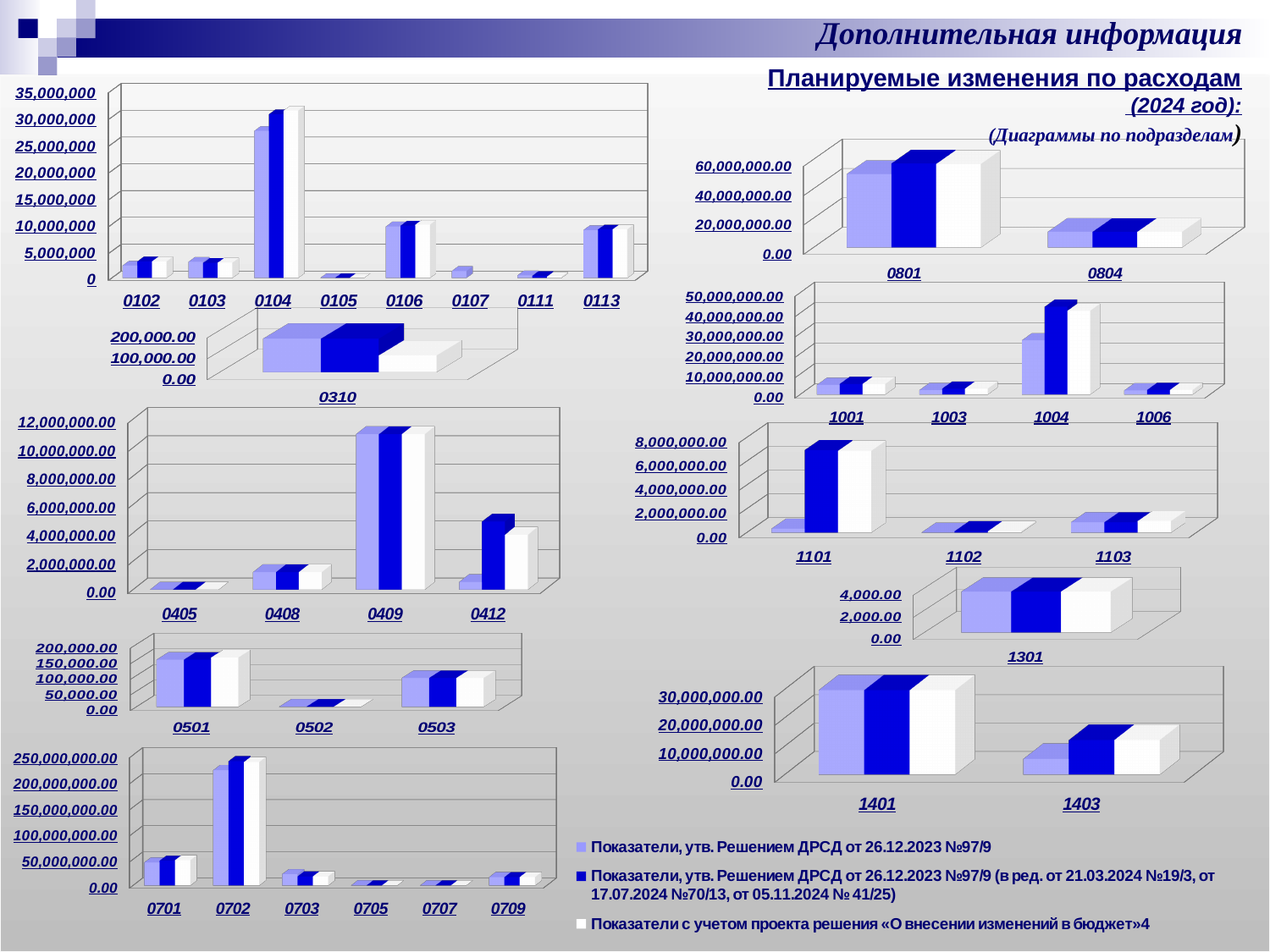
In the chart with categories 0102 to 0113 (top-left), which category has the highest value? 0104 In the chart with categories 0102 to 0113 (top-left), is the value for 0104 greater or less than 25,000,000? greater In the chart with categories 0102 to 0113 (top-left), how many categories are shown on the x axis? 8 In the chart with categories 0701 to 0709, is the value for 0702 greater or less than 200,000,000.00? greater In the chart with categories 0405 to 0412, is the value for 0405 greater or less than 2,000,000.00? less In the chart with categories 1001 to 1006, which category has the highest value? 1004 In the chart with categories 0801 and 0804, which category has the larger value? 0801 In the chart with categories 0501 to 0503, which category has the lowest value? 0502 In the chart with categories 0405 to 0412, which category has the highest value? 0409 How many series does the legend at the bottom of the slide list? 3 What kind of chart is used for the chart with categories 1101 to 1103? Bar chart